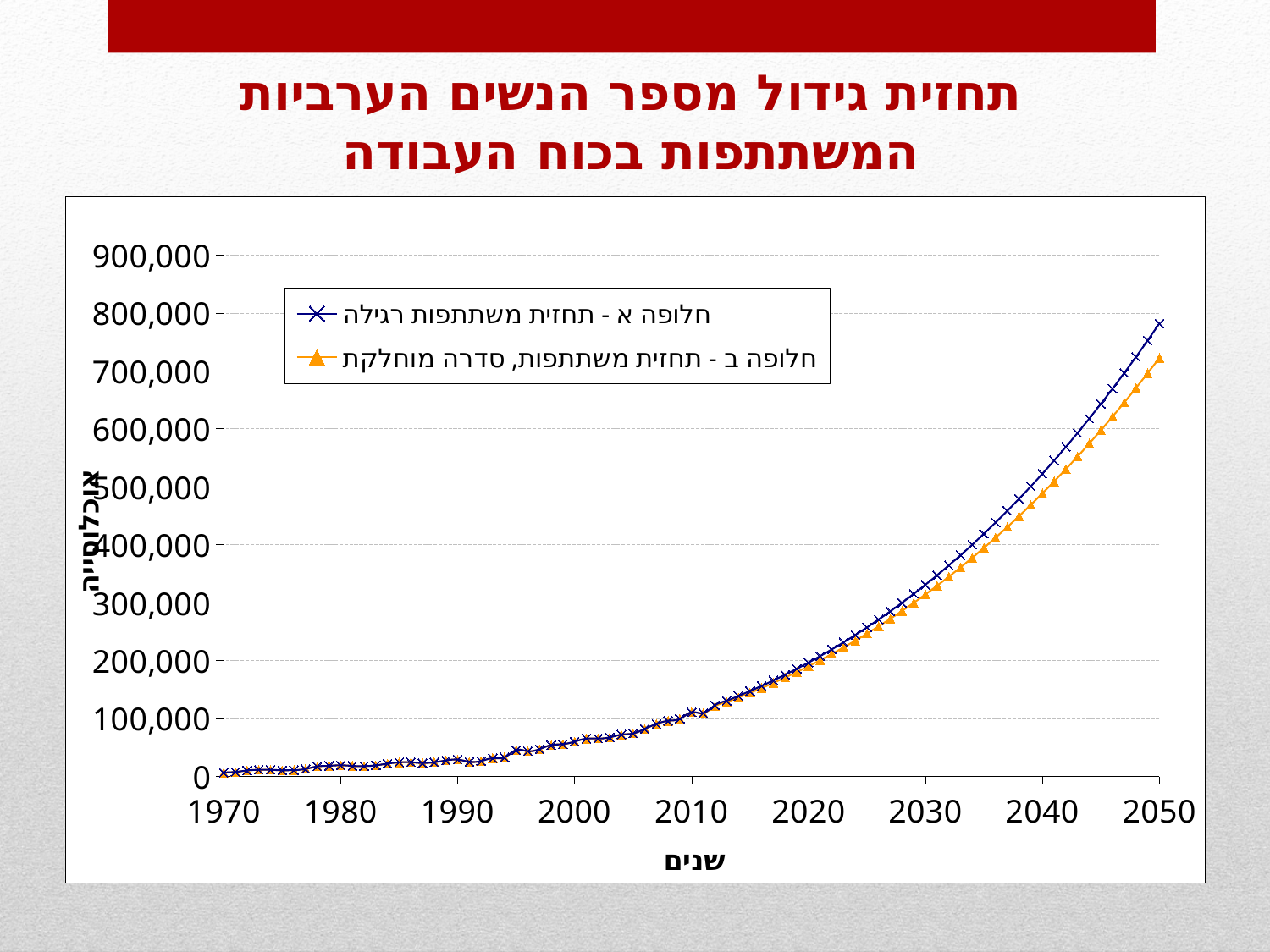
What kind of chart is shown on the slide? line chart In 2050, which series has the higher value: 'חלופה א - תחזית משתתפות רגילה' or 'חלופה ב - תחזית משתתפות, סדרה מוחלקת'? חלופה א - תחזית משתתפות רגילה Is the value for 'חלופה ב - תחזית משתתפות, סדרה מוחלקת' in 2050 greater or less than 600,000? greater In which year does the series 'חלופה א - תחזית משתתפות רגילה' reach its highest value? 2050 Is the value for 'חלופה א - תחזית משתתפות רגילה' in 2050 greater or less than 700,000? greater How many series does the legend list? 2 What is the title of the x axis? שנים Do the values of the series 'חלופה א - תחזית משתתפות רגילה' rise or fall from 1970 to 2050? rise Is the value for 'חלופה א - תחזית משתתפות רגילה' in 2030 greater or less than 400,000? less How many year labels are shown on the x axis? 9